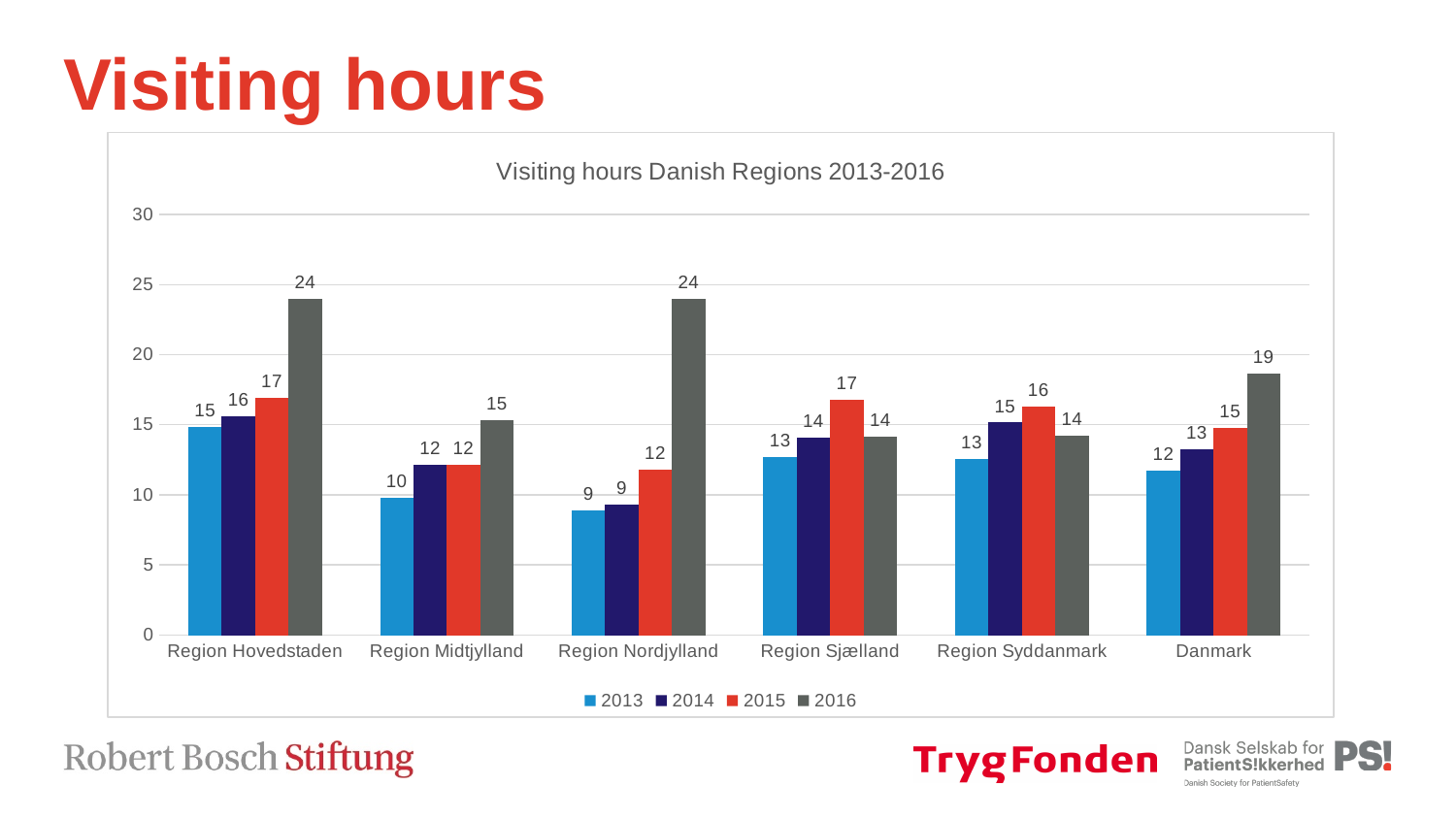
What is the value for Region Hovedstaden in 2016? 24 How many series does the legend list? 4 What is the value for Region Sjælland in 2015? 17 Which category has the highest value in 2014? Region Hovedstaden Which region has the lowest value in 2013? Region Nordjylland What kind of chart is shown on the slide? Bar chart What is the value for Region Nordjylland in 2013? 9 What is the difference between the 2016 and 2013 values for Danmark? 7 Which is larger in 2016: Region Midtjylland or Region Syddanmark? Region Midtjylland Do the values for Danmark rise or fall from 2013 to 2016? Rise What is the title of the chart? Visiting hours Danish Regions 2013-2016 How many categories are shown on the x axis? 6